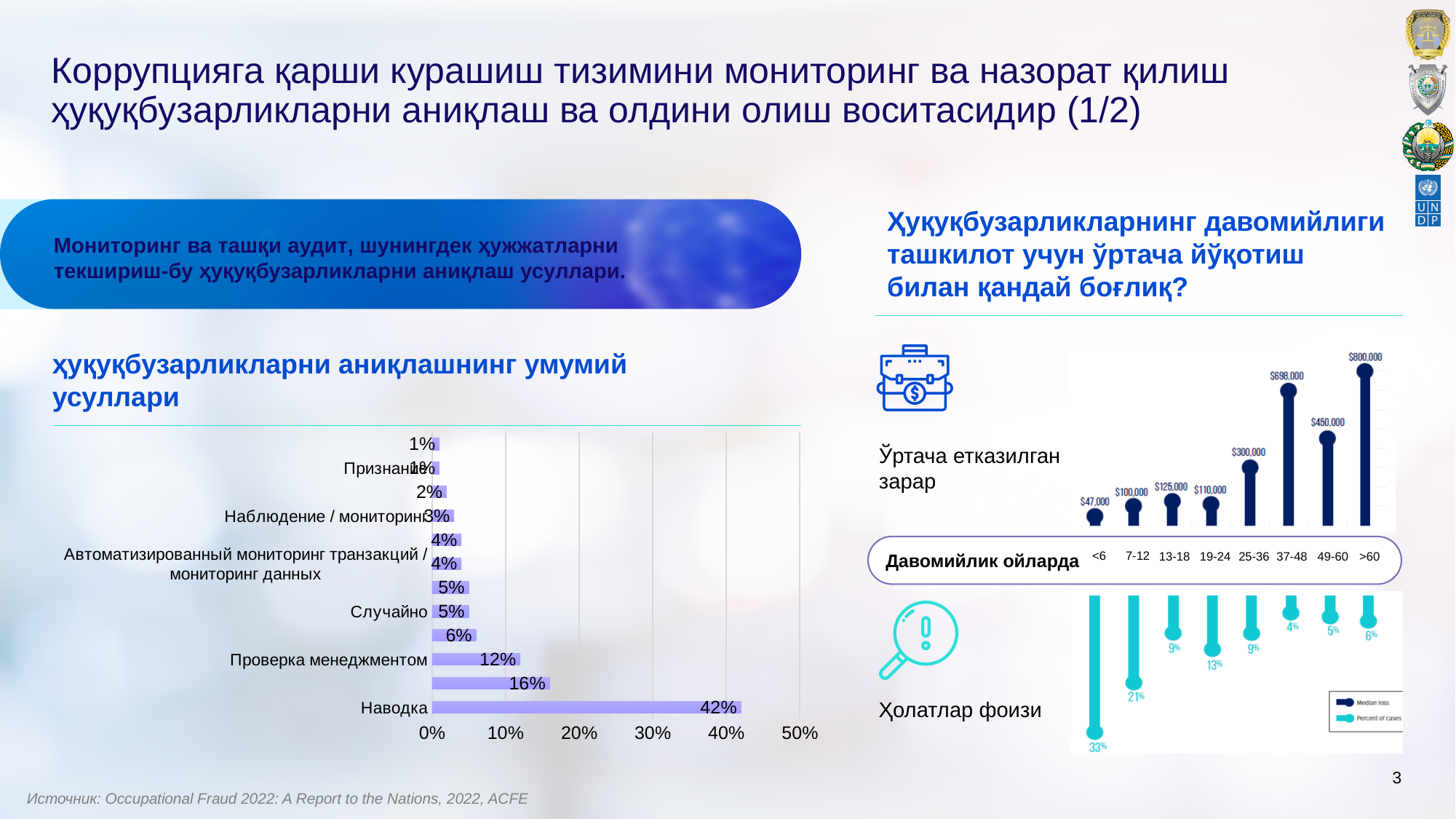
In the right chart, which duration group has the highest percent of cases (Ҳолатлар фоизи)? <6 In the right chart (Ўртача етказилган зарар), what is the median loss for the >60 months duration? $800,000 In the left chart, how many bars are plotted? 12 In the left chart, what is the difference between the values for Наводка and Проверка менеджментом? 30% In the left chart, which labelled category has the highest value? Наводка What kind of chart is the left chart? bar chart In the left chart, what is the value for Случайно? 5% In the left chart (ҳуқуқбузарликларни аниқлашнинг умумий усуллари), what is the value for Наводка? 42% In the right chart, what is the median loss for the 37-48 months duration? $698,000 In the left chart, which is larger: the value for Случайно or the value for Наблюдение / мониторинг? Случайно In the left chart, what is the value for Проверка менеджментом? 12% How many series does the legend of the right chart list? 2